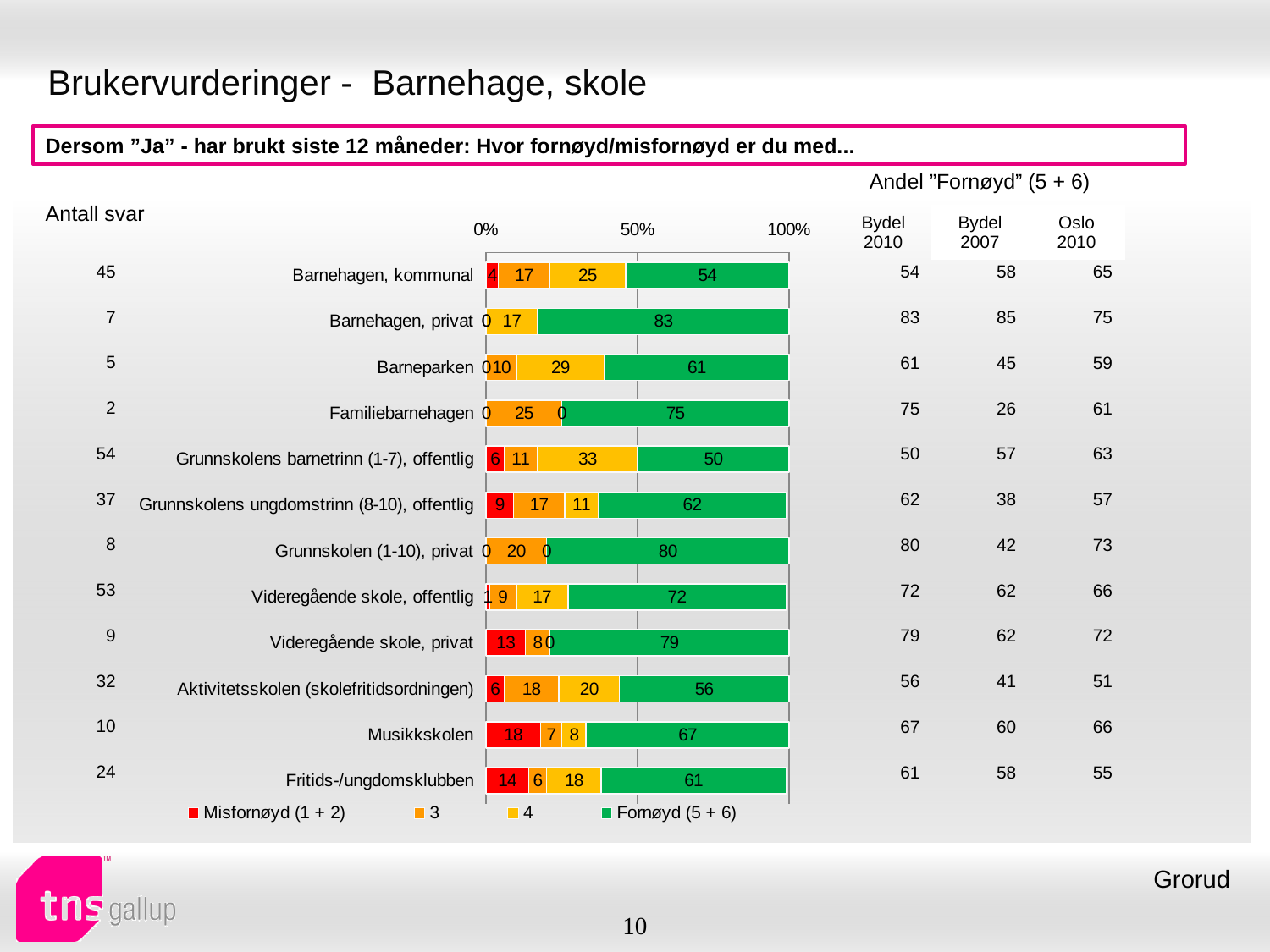
What is the Misfornøyd (1 + 2) value for Musikkskolen? 18 Which category has the lowest Fornøyd (5 + 6) value? Grunnskolens barnetrinn (1-7), offentlig What is the value of series 4 for Grunnskolens barnetrinn (1-7), offentlig? 33 How many series does the legend list? 4 What is the Fornøyd (5 + 6) value for Barnehagen, kommunal? 54 What kind of chart is shown on the slide? Stacked bar chart Which category has the highest Fornøyd (5 + 6) value? Barnehagen, privat Which has a larger Fornøyd (5 + 6) value, Musikkskolen or Fritids-/ungdomsklubben? Musikkskolen Which category has the highest Misfornøyd (1 + 2) value? Musikkskolen What is the difference between the Fornøyd (5 + 6) values for Grunnskolen (1-10), privat and Aktivitetsskolen (skolefritidsordningen)? 24 How many categories are shown in the bar chart? 12 What is the first entry in the chart legend? Misfornøyd (1 + 2)